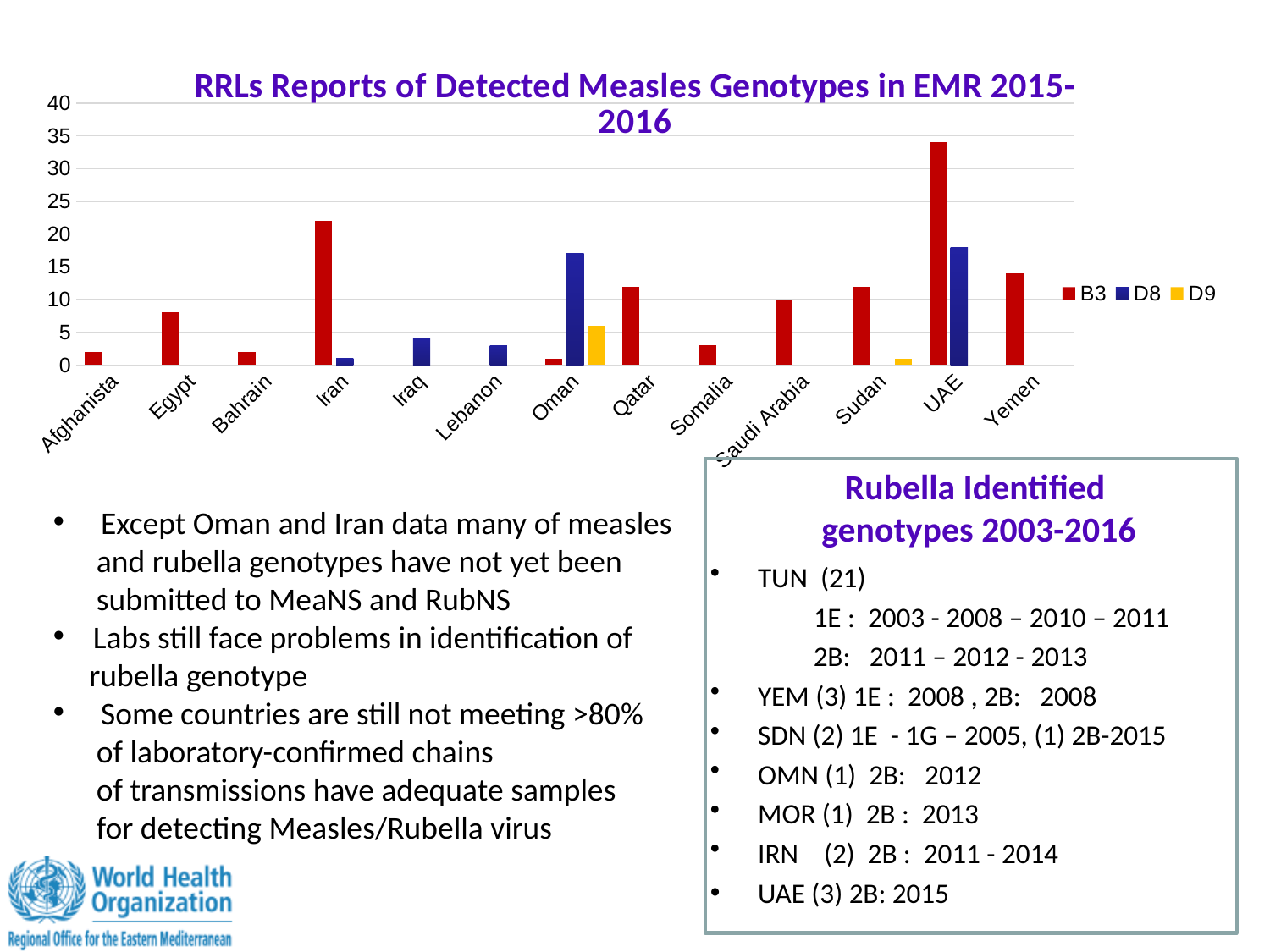
How many countries are shown on the x axis of the chart? 13 How many series does the legend of the chart list? 3 Is the B3 value for UAE greater or less than 30? greater For Oman, which series has the larger value, B3 or D8? D8 Which country has the tallest D9 bar in the chart? Oman What are the series names listed in the chart legend? B3, D8, D9 Is the B3 value for Qatar greater or less than 10? greater Which country has the highest B3 value in the chart? UAE Is the B3 value for Iran greater or less than 20? greater What kind of chart is shown on the slide? bar chart What is the title of the chart? RRLs Reports of Detected Measles Genotypes in EMR 2015-2016 Which is larger, the B3 value for Iran or the B3 value for Egypt? Iran